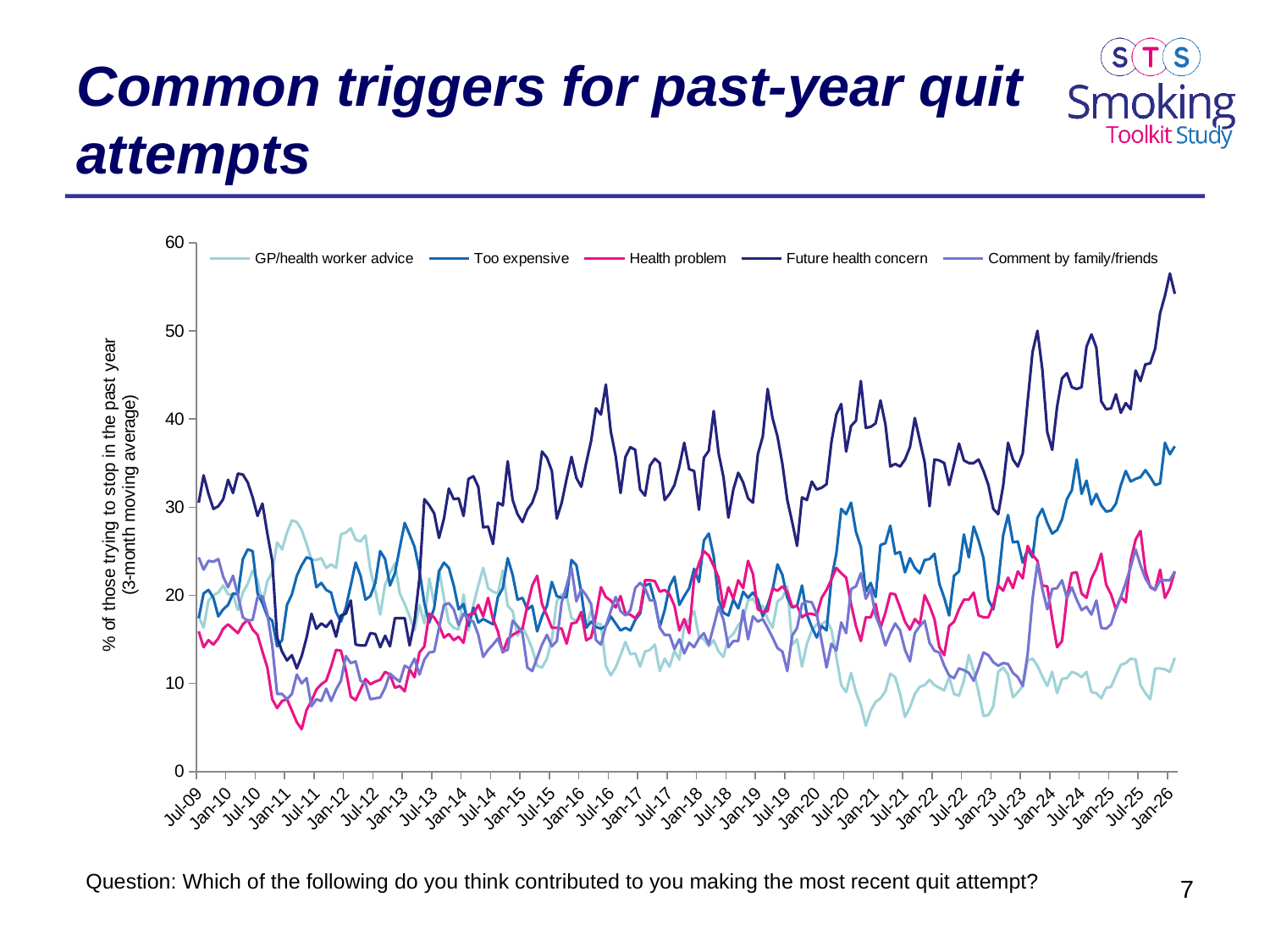
Which series reaches the highest value anywhere on the chart? Future health concern Which series has the lowest value at Jan-26? GP/health worker advice At Jan-26, which is larger: Future health concern or GP/health worker advice? Future health concern Does the Future health concern line generally rise or fall between Jan-23 and Jan-26? rise Is the value for GP/health worker advice at Jan-21 greater or less than 10? less Is the value for Future health concern at Jan-26 greater or less than 50? greater Is the value for Future health concern at Jan-11 greater or less than 20? less What is the label on the vertical axis? % of those trying to stop in the past year (3-month moving average) What are the five series listed in the legend? GP/health worker advice, Too expensive, Health problem, Future health concern, Comment by family/friends How many series does the legend list? 5 What kind of chart is shown on the slide? line chart